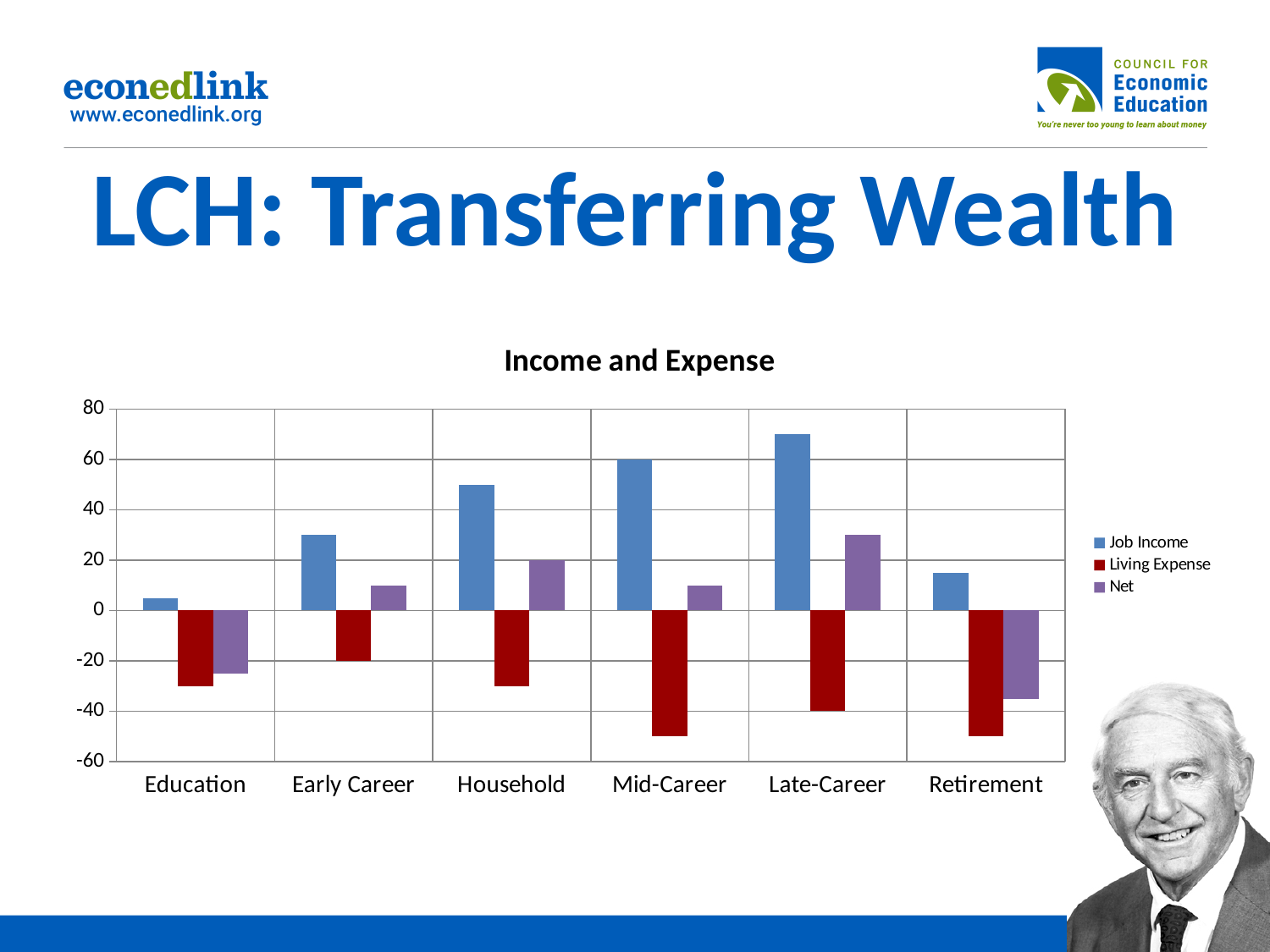
Which category has the lowest Net value? Retirement Does Job Income rise or fall from Education to Late-Career? rise Is the Job Income value for Late-Career greater or less than 60? greater What is the Net value for Household? 20 Which category has the lowest Job Income? Education How many life-stage categories are shown on the x axis of the Income and Expense chart? 6 Which category has the highest Job Income? Late-Career What is the Living Expense value for Early Career? -20 Which has the larger Job Income, Household or Early Career? Household What type of chart is shown on the slide? bar chart What is the Job Income value for Mid-Career? 60 How many series does the legend of the Income and Expense chart list? 3